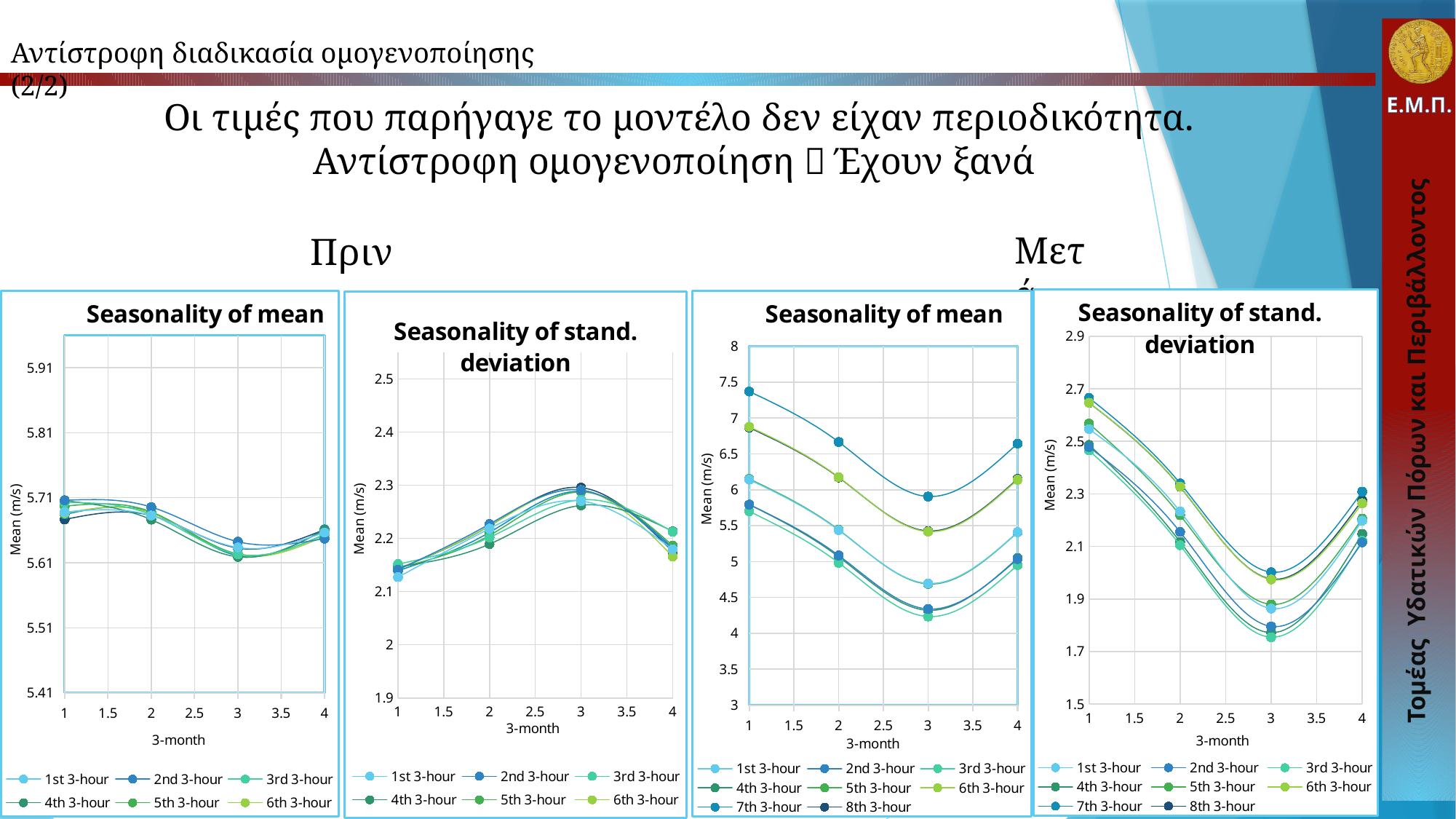
In the third chart from the left, 'Seasonality of mean' (under Μετά), is the value for the 1st 3-hour series at 3-month 3 greater or less than 5? less In the third chart from the left, 'Seasonality of mean' (under Μετά), do the values of the 7th 3-hour series rise or fall from 3-month 1 to 3-month 3? fall How many series does the legend list in the leftmost 'Seasonality of mean' chart (under Πριν)? 6 In the third chart from the left, 'Seasonality of mean' (under Μετά), is the value for the 7th 3-hour series at 3-month 1 greater or less than 7? greater How many series does the legend list in the third chart from the left, 'Seasonality of mean' (under Μετά)? 8 In the rightmost 'Seasonality of stand. deviation' chart (under Μετά), is the value for the 2nd 3-hour series at 3-month 3 greater or less than 1.9? less What kind of chart is the leftmost 'Seasonality of mean' chart (under Πριν)? line chart In the second chart from the left, 'Seasonality of stand. deviation' (under Πριν), how many data points does each series have? 4 How many series does the legend list in the rightmost 'Seasonality of stand. deviation' chart (under Μετά)? 8 What is the x-axis label of the leftmost 'Seasonality of mean' chart (under Πριν)? 3-month In the second chart from the left, 'Seasonality of stand. deviation' (under Πριν), do the values rise or fall from 3-month 1 to 3-month 3? rise